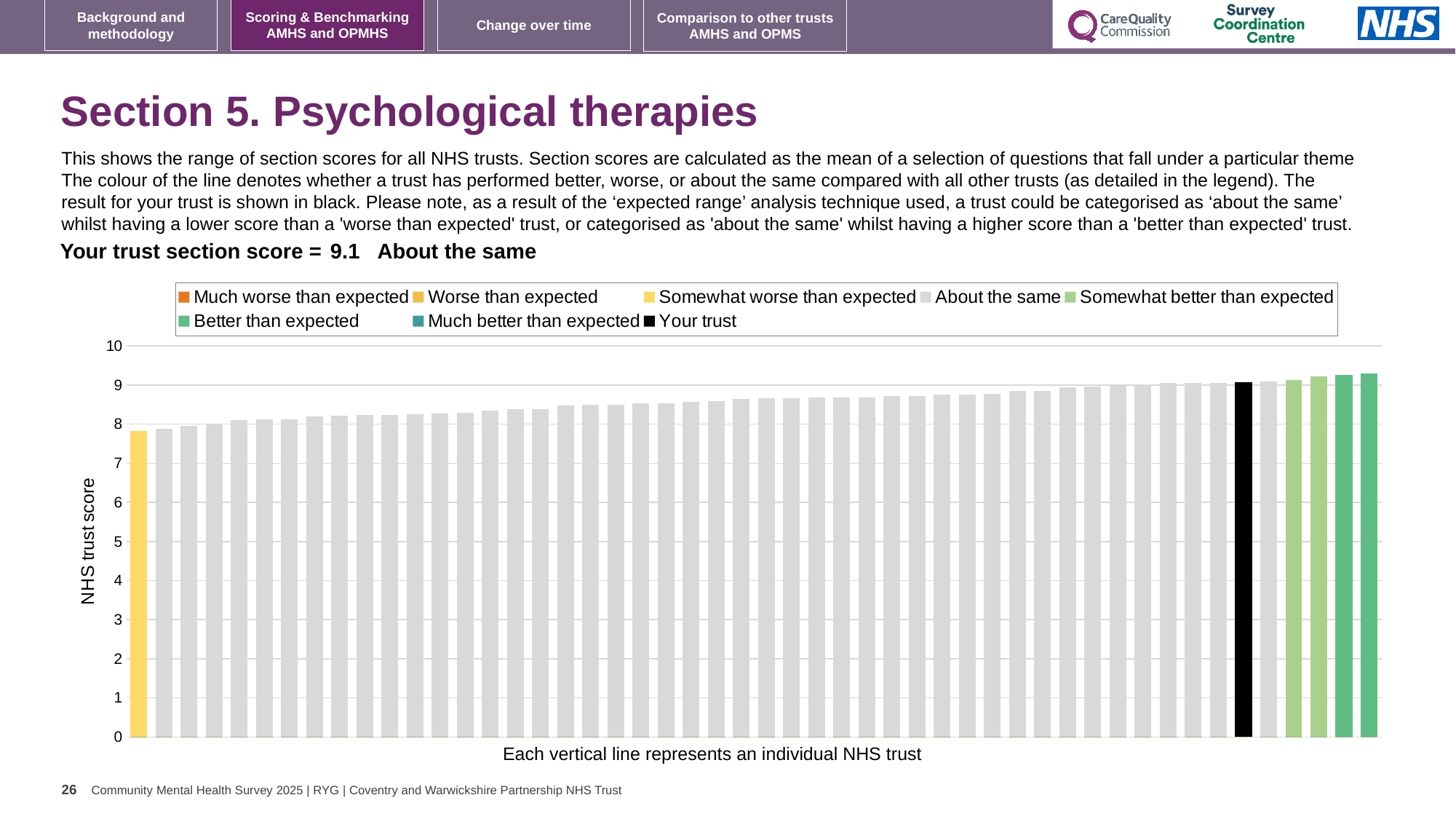
Which legend category does the tallest bar on the right belong to? Better than expected Do the bar values rise or fall from left to right along the x axis? rise What is the section score for your trust? 9.1 How many entries does the chart legend list? 8 Is the value for your trust (the black bar) greater or less than 8? greater Is the value of the lowest bar greater or less than 7? greater What colour is the bar representing your trust? black Which benchmarking category is your trust placed in for this section? About the same What is the title of the vertical axis? NHS trust score Is the value of the highest bar greater or less than 10? less What kind of chart is shown on the slide? bar chart